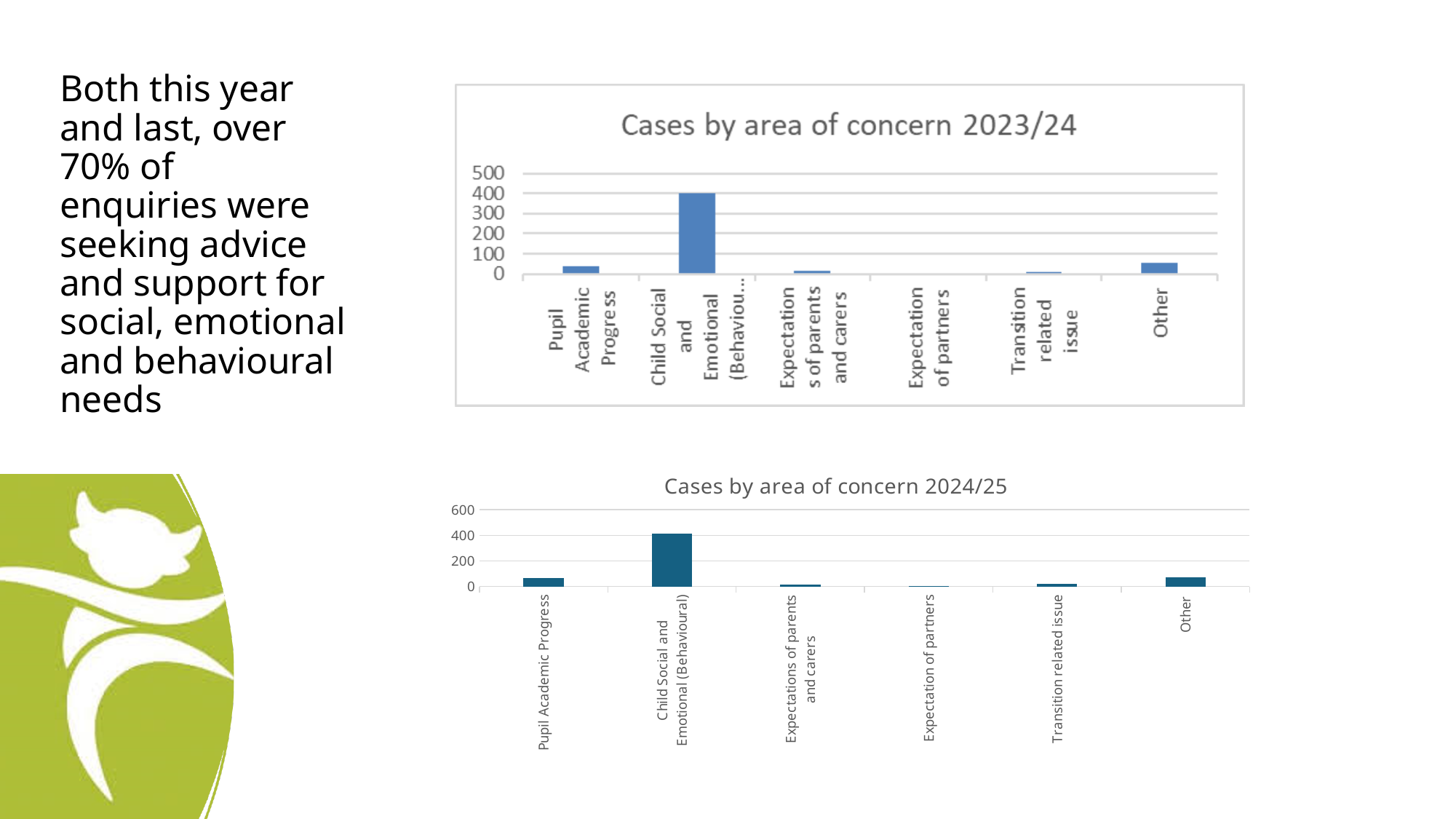
In the top chart 'Cases by area of concern 2023/24', which area of concern has the lowest number of cases? Expectation of partners In the bottom chart 'Cases by area of concern 2024/25', which is larger: Other or Expectations of parents and carers? Other In the top chart 'Cases by area of concern 2023/24', is the value for Other greater or less than 100? less In the top chart 'Cases by area of concern 2023/24', is the value for Child Social and Emotional (Behavioural) greater or less than 300? greater What is the title of the bottom chart on the slide? Cases by area of concern 2024/25 In the top chart 'Cases by area of concern 2023/24', which is larger: Pupil Academic Progress or Transition related issue? Pupil Academic Progress In the bottom chart 'Cases by area of concern 2024/25', is the value for Child Social and Emotional (Behavioural) greater or less than 200? greater In the top chart 'Cases by area of concern 2023/24', which area of concern has the highest number of cases? Child Social and Emotional (Behavioural) In the bottom chart 'Cases by area of concern 2024/25', which area of concern has the highest number of cases? Child Social and Emotional (Behavioural) How many categories are shown on the x axis of the top chart 'Cases by area of concern 2023/24'? 6 What kind of chart is the top chart, 'Cases by area of concern 2023/24'? bar chart